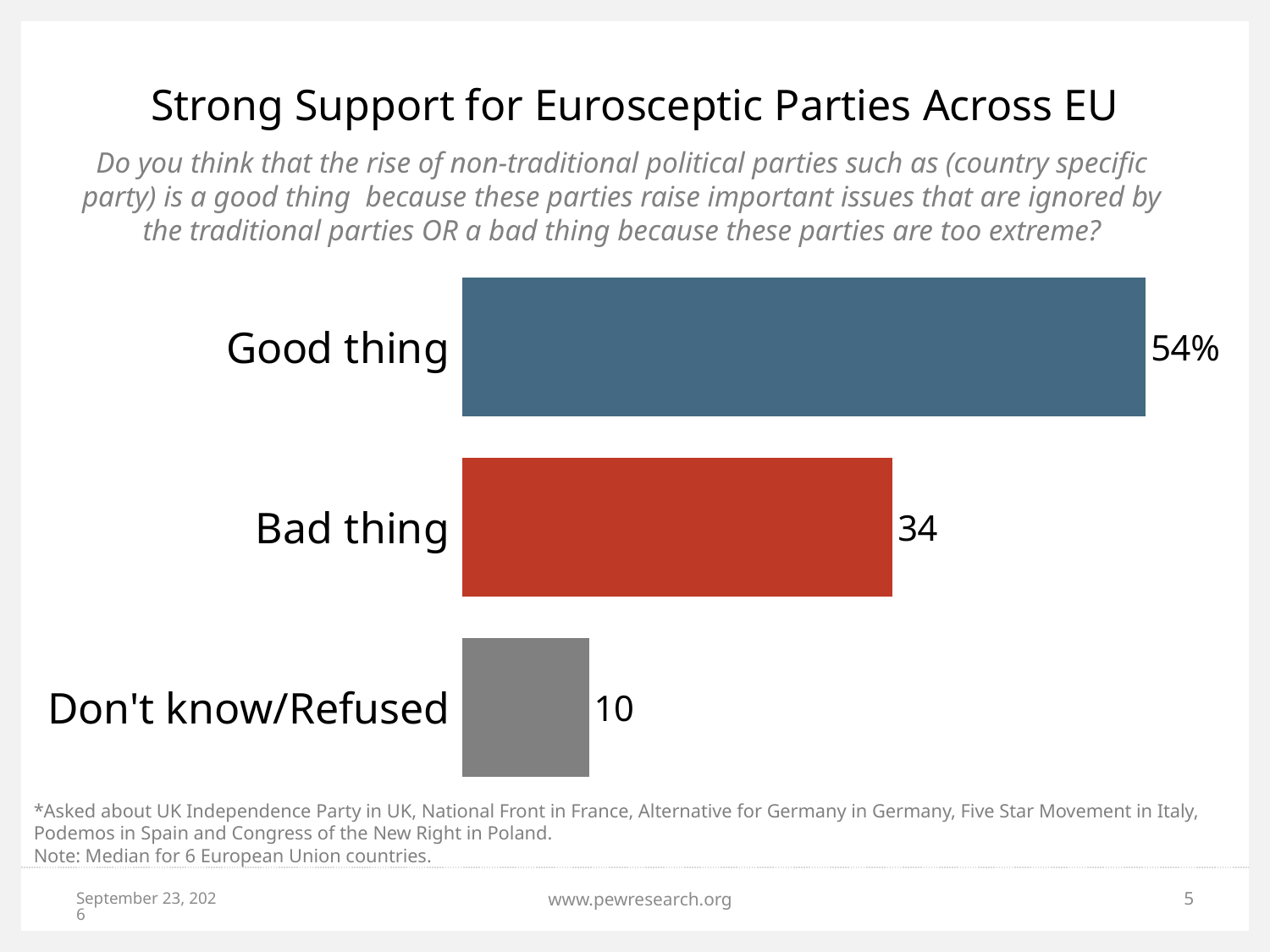
What is the difference between the values for Good thing and Bad thing? 20 Which is larger, the value for Bad thing or the value for Don't know/Refused? Bad thing What is the value for Don't know/Refused? 10 What is the title of the chart? Strong Support for Eurosceptic Parties Across EU Which category has the highest value? Good thing What kind of chart is shown on the slide? Bar chart What is the difference between the values for Bad thing and Don't know/Refused? 24 What is the value for Good thing? 54% How many categories are shown in the chart? 3 What colour is the bar for Bad thing? Red What is the value for Bad thing? 34 Which category has the lowest value? Don't know/Refused